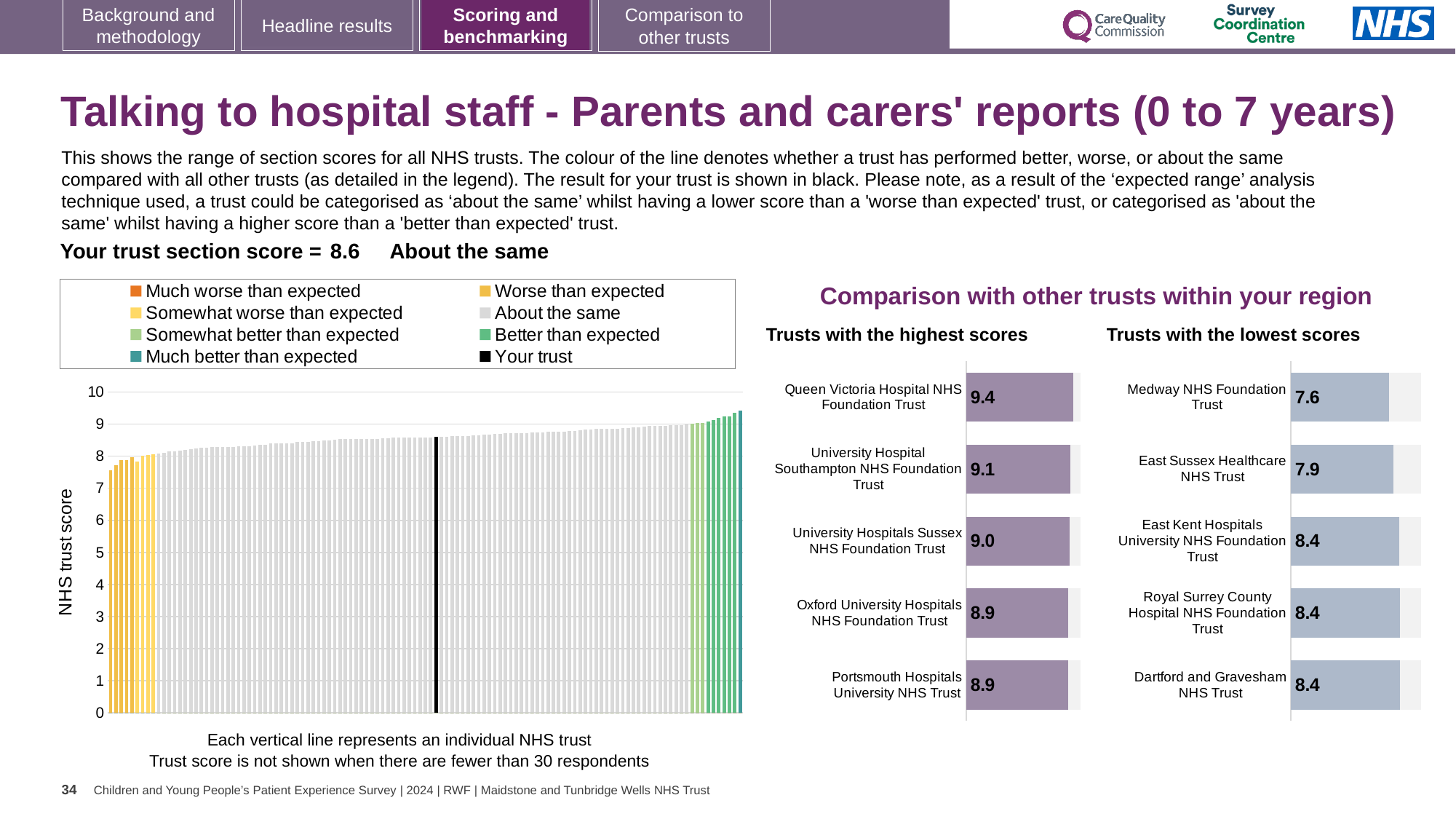
How many entries does the legend above the large chart on the left list? 8 In the 'Trusts with the highest scores' chart, what is the score for Queen Victoria Hospital NHS Foundation Trust? 9.4 In the 'Trusts with the lowest scores' chart, which is larger: the score for East Sussex Healthcare NHS Trust or the score for East Kent Hospitals University NHS Foundation Trust? East Kent Hospitals University NHS Foundation Trust In the large chart on the left, do the trust scores rise or fall from left to right? Rise In the 'Trusts with the highest scores' chart, which trust has the highest score? Queen Victoria Hospital NHS Foundation Trust In the 'Trusts with the lowest scores' chart, what is the score for Medway NHS Foundation Trust? 7.6 In the 'Trusts with the highest scores' chart, how many trusts are shown? 5 What is the difference between the score for Queen Victoria Hospital NHS Foundation Trust in the highest scores chart and the score for Medway NHS Foundation Trust in the lowest scores chart? 1.8 In the 'Trusts with the highest scores' chart, what is the score for University Hospitals Sussex NHS Foundation Trust? 9.0 What kind of chart is the large chart on the left showing all NHS trust scores? Bar chart In the 'Trusts with the lowest scores' chart, which trust has the lowest score? Medway NHS Foundation Trust In the 'Trusts with the lowest scores' chart, what is the score for East Sussex Healthcare NHS Trust? 7.9